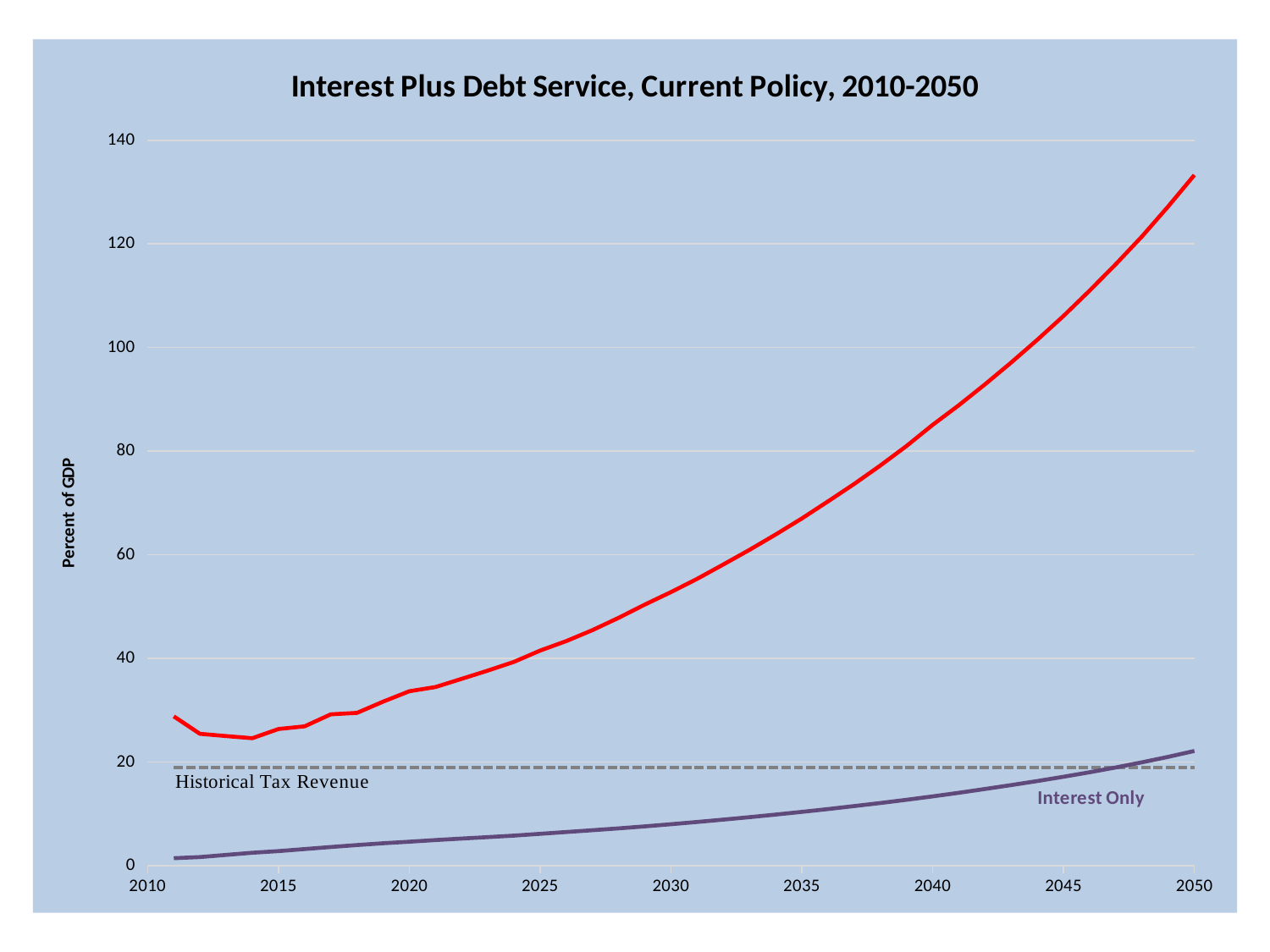
In 2050, which is larger: the red line or the Interest Only line? The red line What is the label on the vertical axis? Percent of GDP Does the red line rise or fall between 2020 and 2050? Rises Is the value of the Interest Only line in 2030 greater or less than 20? less What is the title of the chart? Interest Plus Debt Service, Current Policy, 2010-2050 Is the value of the Interest Only line in 2050 greater or less than 20? greater Is the value of the red line in 2020 greater or less than 20? greater What type of chart is shown on the slide? Line chart What is the highest value shown on the vertical axis? 140 Does the Interest Only line rise or fall from 2010 to 2050? Rises